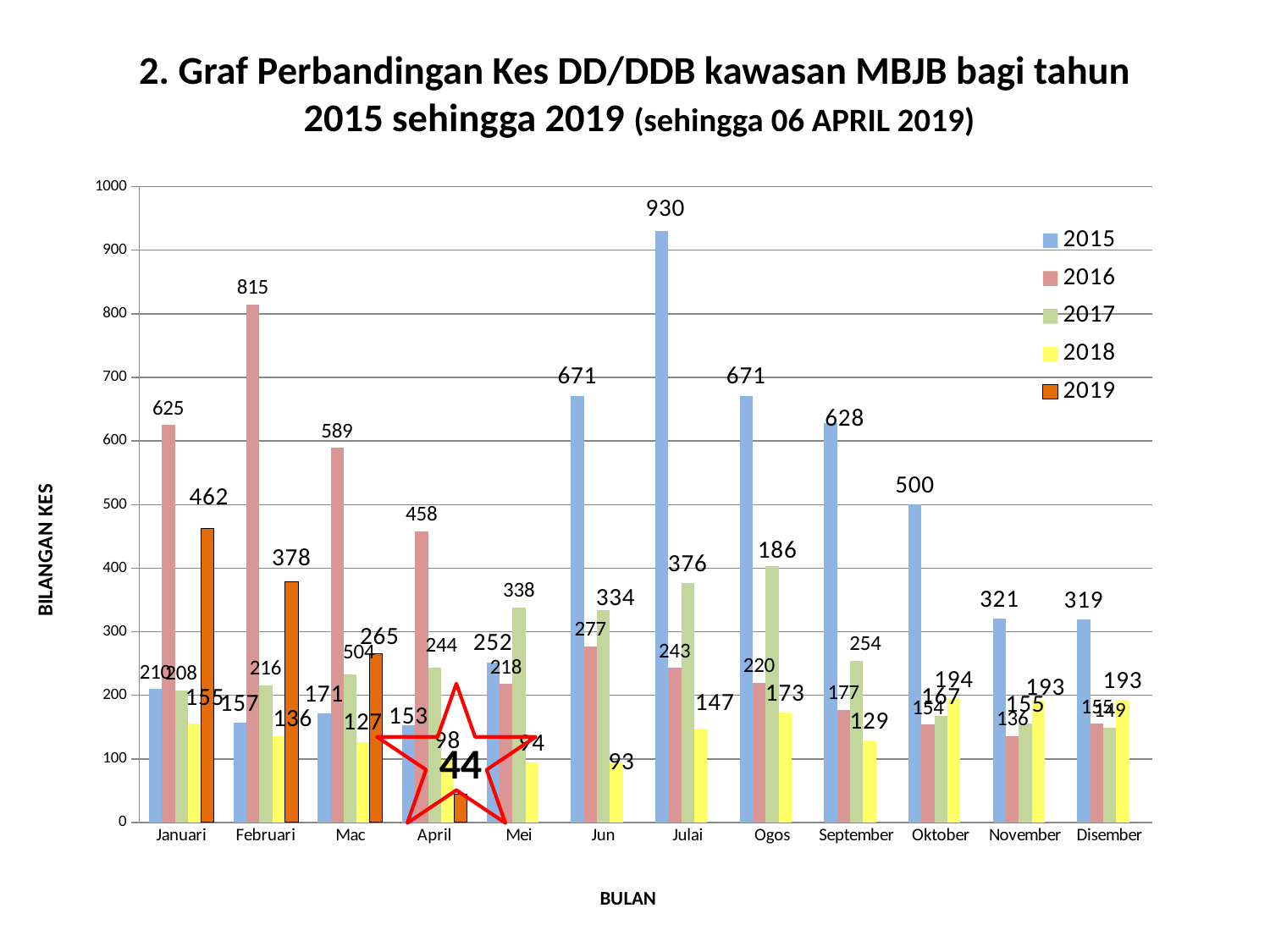
What is the value for 2016 in Februari? 815 Do the 2019 values rise or fall from Januari to April? fall In which month is the 2019 value lowest? April How many series does the legend list? 5 Which is larger in Mei, the value for 2015 or the value for 2017? 2017 In which month is the 2015 value highest? Julai What kind of chart is shown on the slide? bar chart What is the value for 2019 in April (inside the star)? 44 What is the difference between the 2016 and 2015 values in Januari? 415 How many months are shown along the x axis? 12 What is the value for 2015 in Julai? 930 Which colour represents the 2019 series in the legend? orange